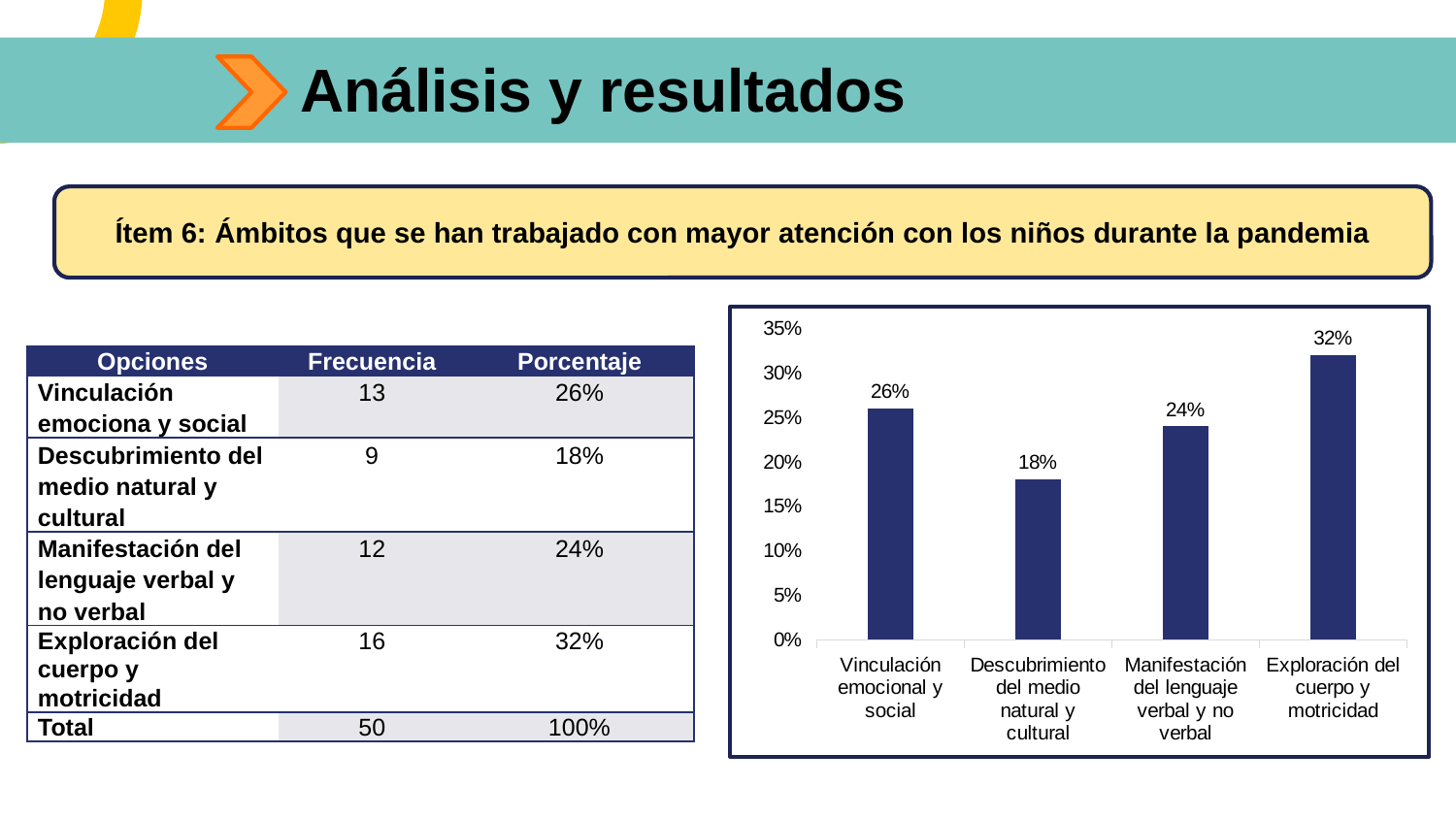
How many categories are shown in the chart? 4 Which category has the lowest value in the chart? Descubrimiento del medio natural y cultural What is the highest value shown on the chart's vertical axis? 35% Which is larger: the value for Manifestación del lenguaje verbal y no verbal or the value for Descubrimiento del medio natural y cultural? Manifestación del lenguaje verbal y no verbal What is the value for Descubrimiento del medio natural y cultural in the chart? 18% Is the value for Exploración del cuerpo y motricidad greater or less than 30%? greater What is the difference between the values for Vinculación emocional y social and Manifestación del lenguaje verbal y no verbal? 2% What kind of chart is shown on the slide? bar chart What is the value for Exploración del cuerpo y motricidad in the chart? 32% What is the difference between the values for Exploración del cuerpo y motricidad and Descubrimiento del medio natural y cultural? 14% Which category has the highest value in the chart? Exploración del cuerpo y motricidad What is the value for Vinculación emocional y social in the chart? 26%